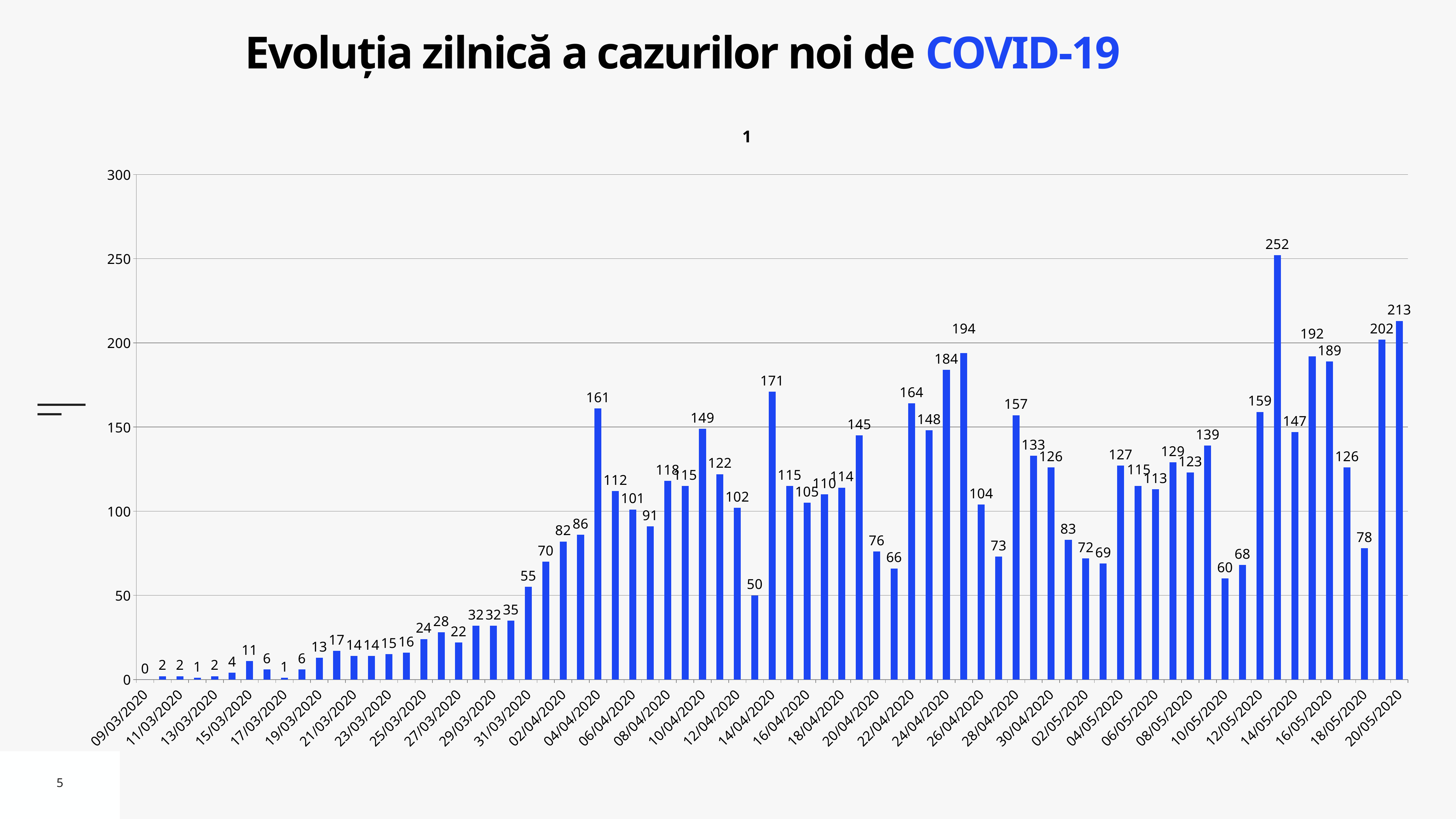
Which is larger, the value for 24/04/2020 or the value for 22/04/2020? 24/04/2020 Is the value for 04/04/2020 greater or less than 150? greater Which date has the lowest value on the chart? 09/03/2020 What is the highest value shown on the chart? 252 Do the values generally rise or fall from 09/03/2020 to 20/05/2020? rise What is the difference between the values for 20/05/2020 and 18/05/2020? 135 What is the value for 14/04/2020? 171 What colour are the bars in the chart? blue What is the title of the slide? Evoluția zilnică a cazurilor noi de COVID-19 What kind of chart is shown on the slide? bar chart What is the value for 20/05/2020? 213 What is the value for 31/03/2020? 55